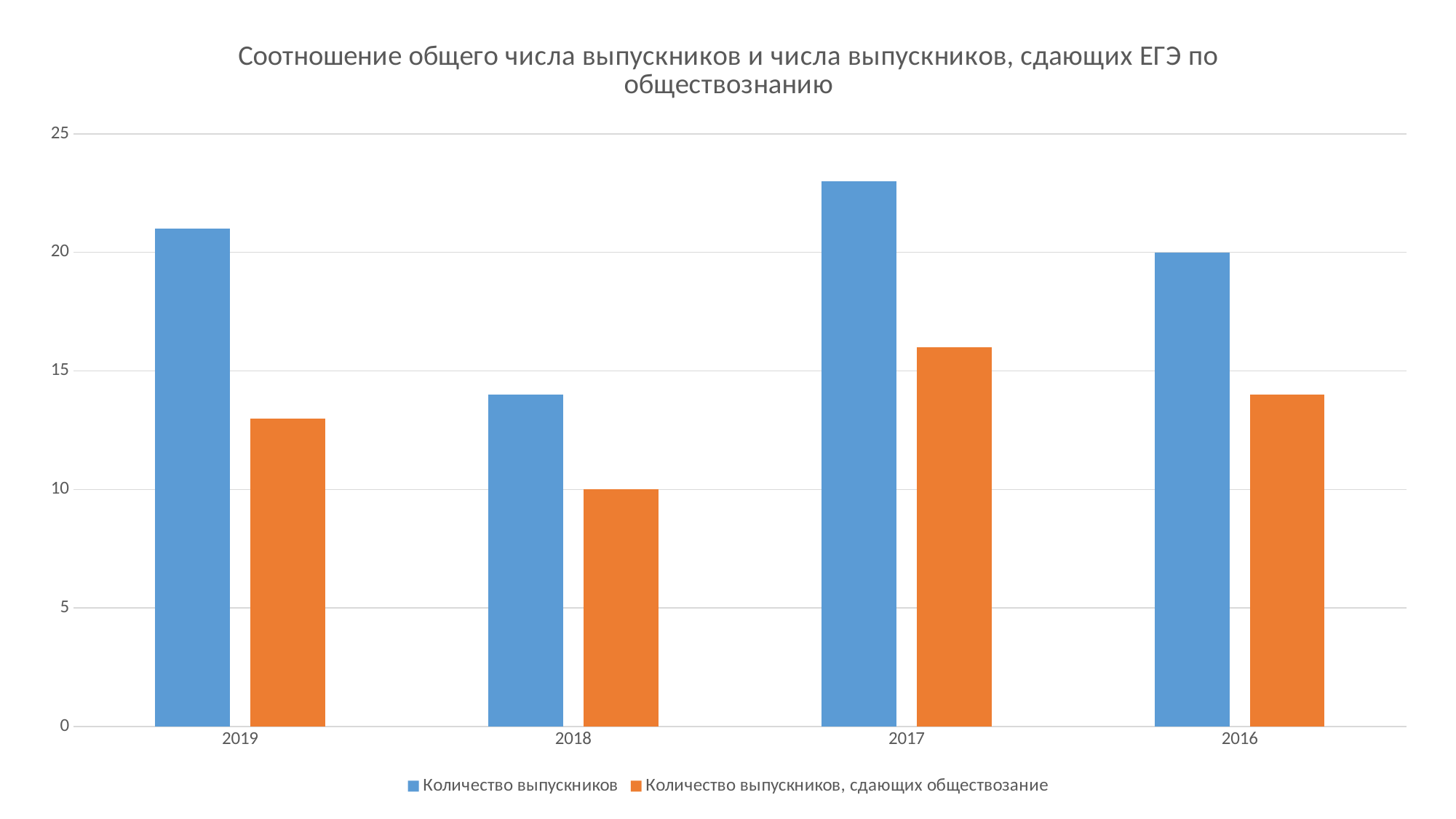
Is the value for "Количество выпускников" in 2019 greater or less than 20? greater How many years are shown on the x axis? 4 Which year has the highest value for "Количество выпускников"? 2017 Which series is shown in orange in the legend? Количество выпускников, сдающих обществозание How many series does the legend list? 2 Is the value for "Количество выпускников, сдающих обществозание" in 2017 greater or less than 15? greater What kind of chart is shown on the slide? bar chart Which year has the lowest value for "Количество выпускников, сдающих обществозание"? 2018 What is the value of "Количество выпускников" for 2016? 20 Which is larger: "Количество выпускников" in 2019 or "Количество выпускников" in 2016? 2019 Is the value for "Количество выпускников" in 2018 greater or less than 15? less What is the value of "Количество выпускников, сдающих обществозание" for 2018? 10